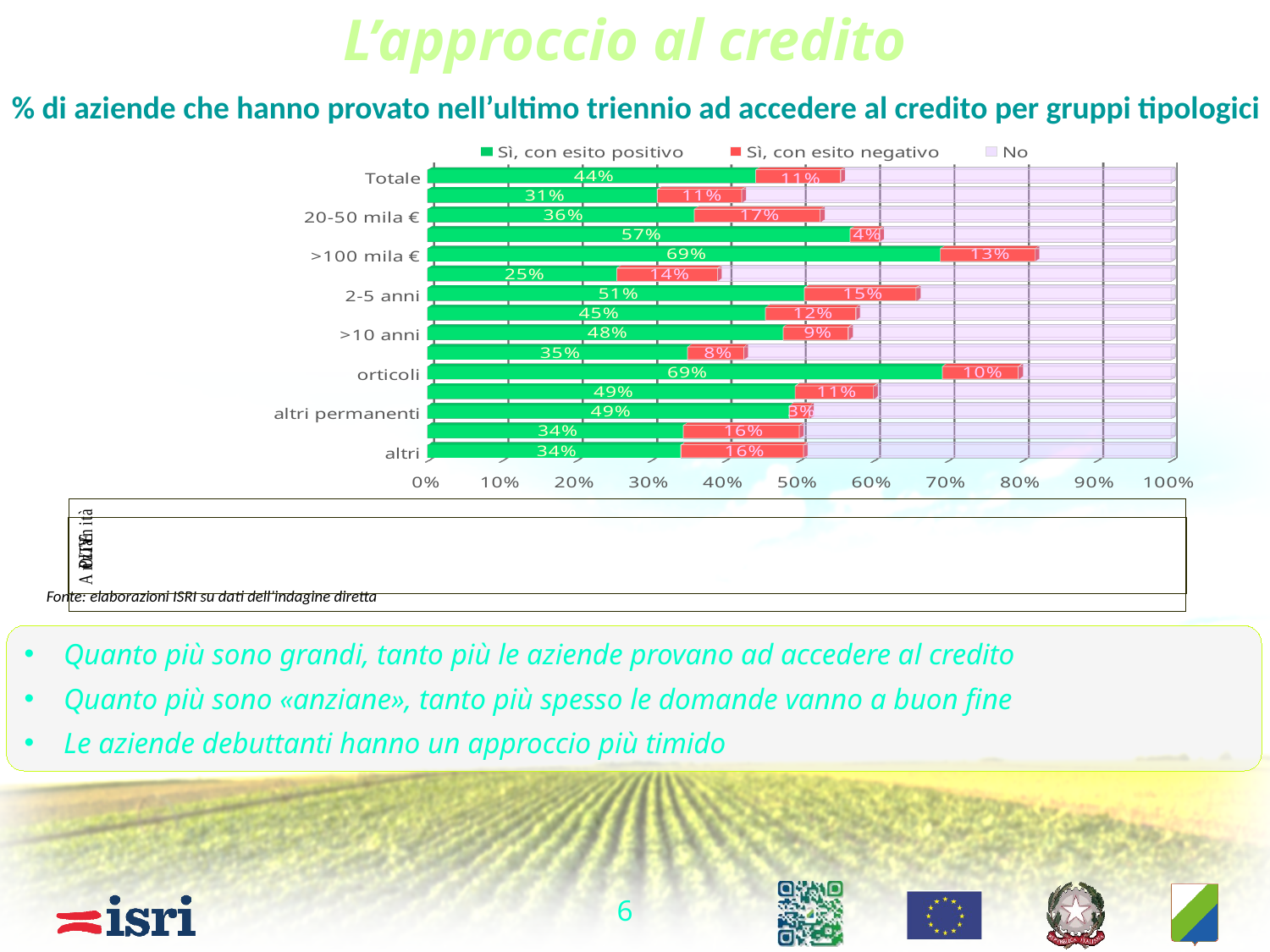
What is the 'Sì, con esito negativo' value for the 'altri' group? 16% What is the 'Sì, con esito positivo' value for the '2-5 anni' group? 51% By how many percentage points does the 'Sì, con esito positivo' value for '>100 mila €' exceed that for '20-50 mila €'? 33 percentage points What is the 'Sì, con esito negativo' value for the 'Totale' group? 11% What kind of chart is shown on the slide? Stacked horizontal bar chart What is the 'Sì, con esito negativo' value for the '20-50 mila €' group? 17% What is the combined share of 'Sì, con esito positivo' and 'Sì, con esito negativo' for the 'Totale' group? 55% How many series does the chart legend list? 3 Which series is shown in green in the chart legend? Sì, con esito positivo What percentage of aziende in the 'Totale' group tried to access credit with a positive outcome (Sì, con esito positivo)? 44% What is the 'Sì, con esito positivo' value for the '>100 mila €' group? 69% Which group has the higher 'Sì, con esito positivo' value: 'orticoli' or 'altri permanenti'? orticoli